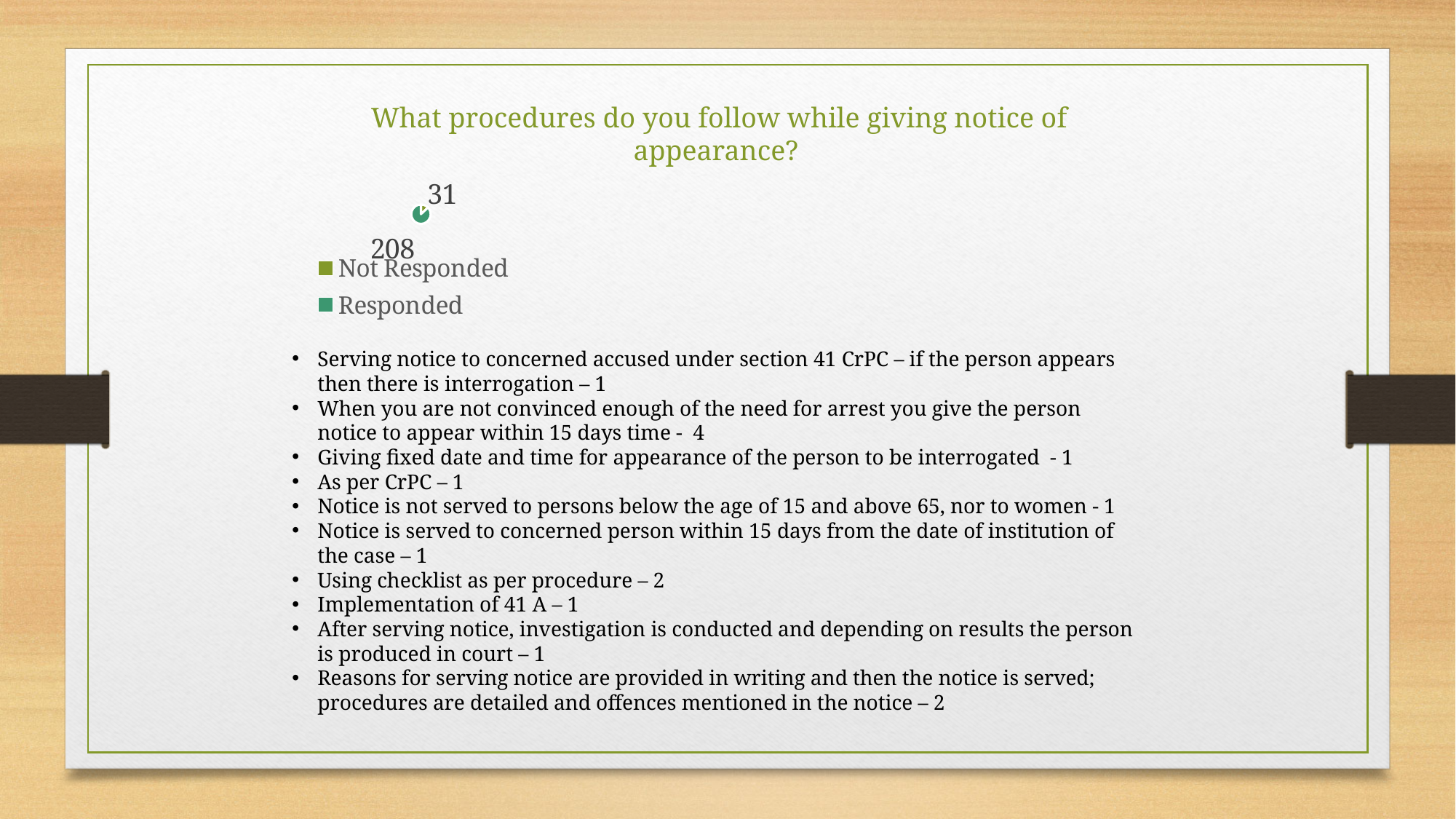
Which category in the pie chart has the larger value? Responded How many slices does the pie chart have? 2 What is the value shown for Responded in the pie chart? 208 What is the value shown for Not Responded in the pie chart? 31 How many categories does the legend of the pie chart list? 2 What kind of chart is shown on the slide? pie chart What is the total of the two values shown in the pie chart? 239 What are the two legend entries of the pie chart? Not Responded, Responded Is the value for Not Responded greater or less than the value for Responded? less What is the title of the slide containing the pie chart? What procedures do you follow while giving notice of appearance? What is the difference between the two values shown in the pie chart, 208 and 31? 177 Which category in the pie chart has the smaller value? Not Responded